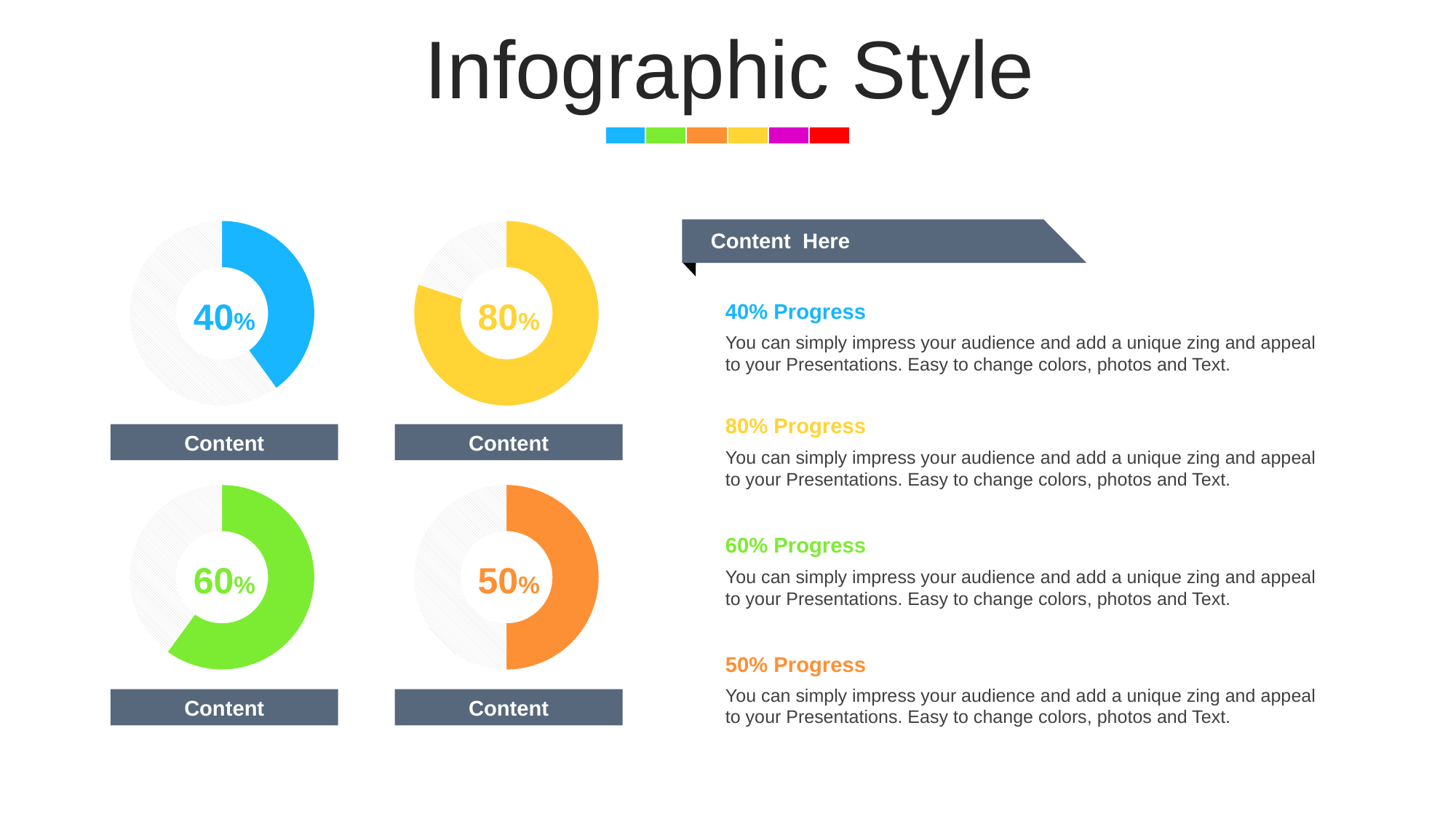
Which of the four doughnut charts shows the highest percentage? The top-right (yellow) chart, 80% What is the difference between the value in the top-right doughnut chart and the value in the top-left doughnut chart? 40% What value is shown in the centre of the top-left doughnut chart? 40% How many doughnut charts are on the slide? 4 What kind of chart is used to show the percentages on the left side of the slide? Doughnut chart What value is shown in the centre of the top-right doughnut chart? 80% What label appears in the bar beneath each doughnut chart? Content What value is shown in the centre of the bottom-left doughnut chart? 60% Which of the four doughnut charts shows the lowest percentage? The top-left (blue) chart, 40% What value is shown in the centre of the bottom-right doughnut chart? 50% Which is larger: the value in the bottom-left doughnut chart or the value in the bottom-right doughnut chart? The bottom-left chart (60%) What colour is the filled ring of the doughnut chart showing 50%? Orange